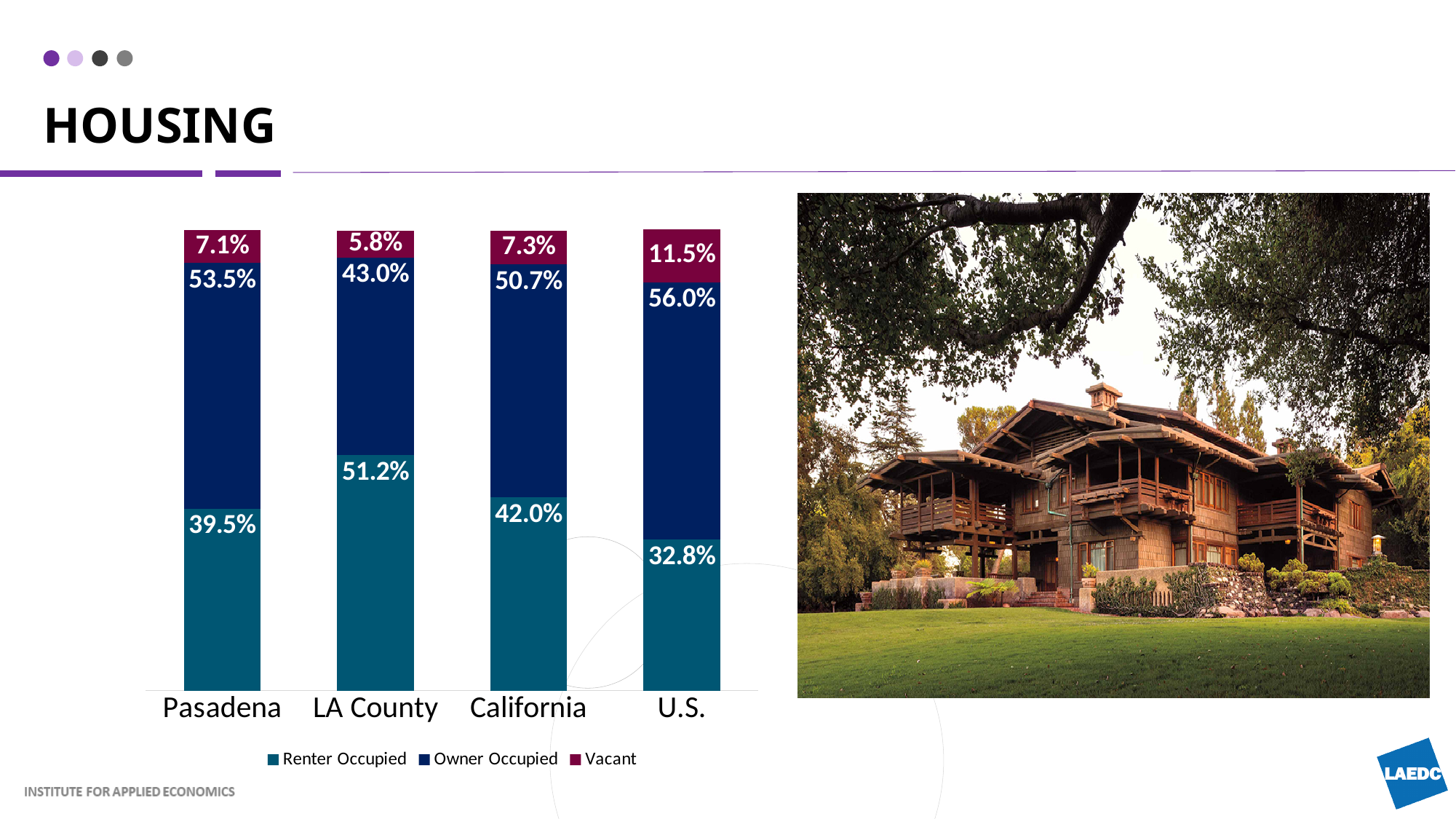
What is the difference between the Owner Occupied shares of the U.S. and LA County? 13.0% Which is larger, the Renter Occupied share for Pasadena or for California? California Which category has the highest Vacant share? U.S. What kind of chart is shown on the slide? Stacked bar chart What is the Owner Occupied share for Pasadena? 53.5% What is the Renter Occupied share for LA County? 51.2% What is the Vacant share for the U.S.? 11.5% What is the title of the slide containing the chart? HOUSING How many categories are shown on the x axis? 4 Which category has the lowest Vacant share? LA County Which category has the lowest Renter Occupied share? U.S. How many series does the legend list? 3